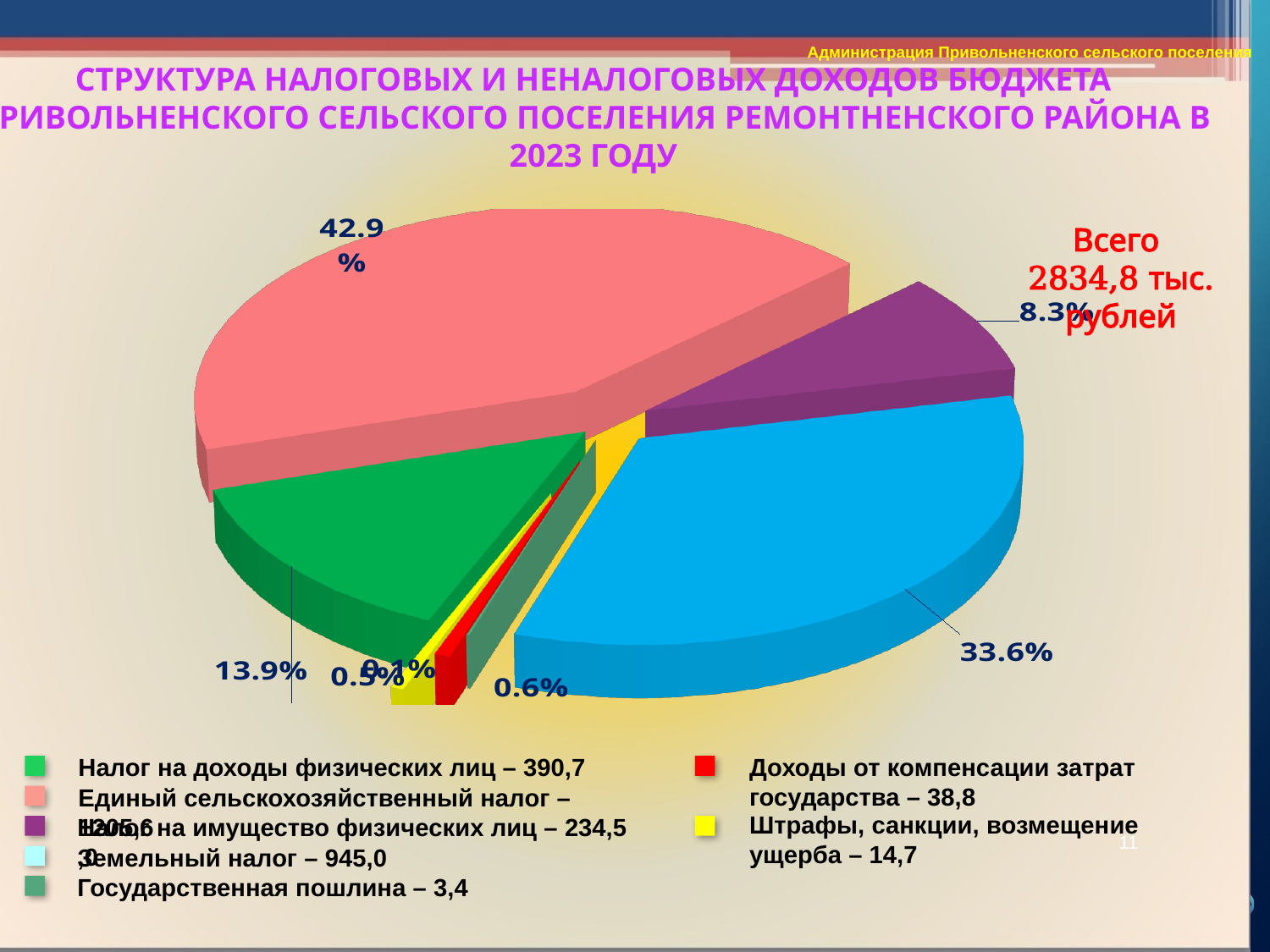
Which category has the smallest value in the legend? Государственная пошлина Which category has the largest share of the pie chart? Единый сельскохозяйственный налог What value is given in the legend for Штрафы, санкции, возмещение ущерба? 14,7 What value is given in the legend for Доходы от компенсации затрат государства? 38,8 How many categories does the legend of the pie chart list? 7 What value is given in the legend for Налог на доходы физических лиц? 390,7 What value is given in the legend for Налог на имущество физических лиц? 234,5 What value is given in the legend for Земельный налог? 945,0 What total amount (Всего) is stated next to the pie chart? 2834,8 тыс. рублей What kind of chart is shown on the slide? pie chart What is the share of the largest slice of the pie chart? 42.9% Which is larger, Земельный налог or Налог на доходы физических лиц? Земельный налог